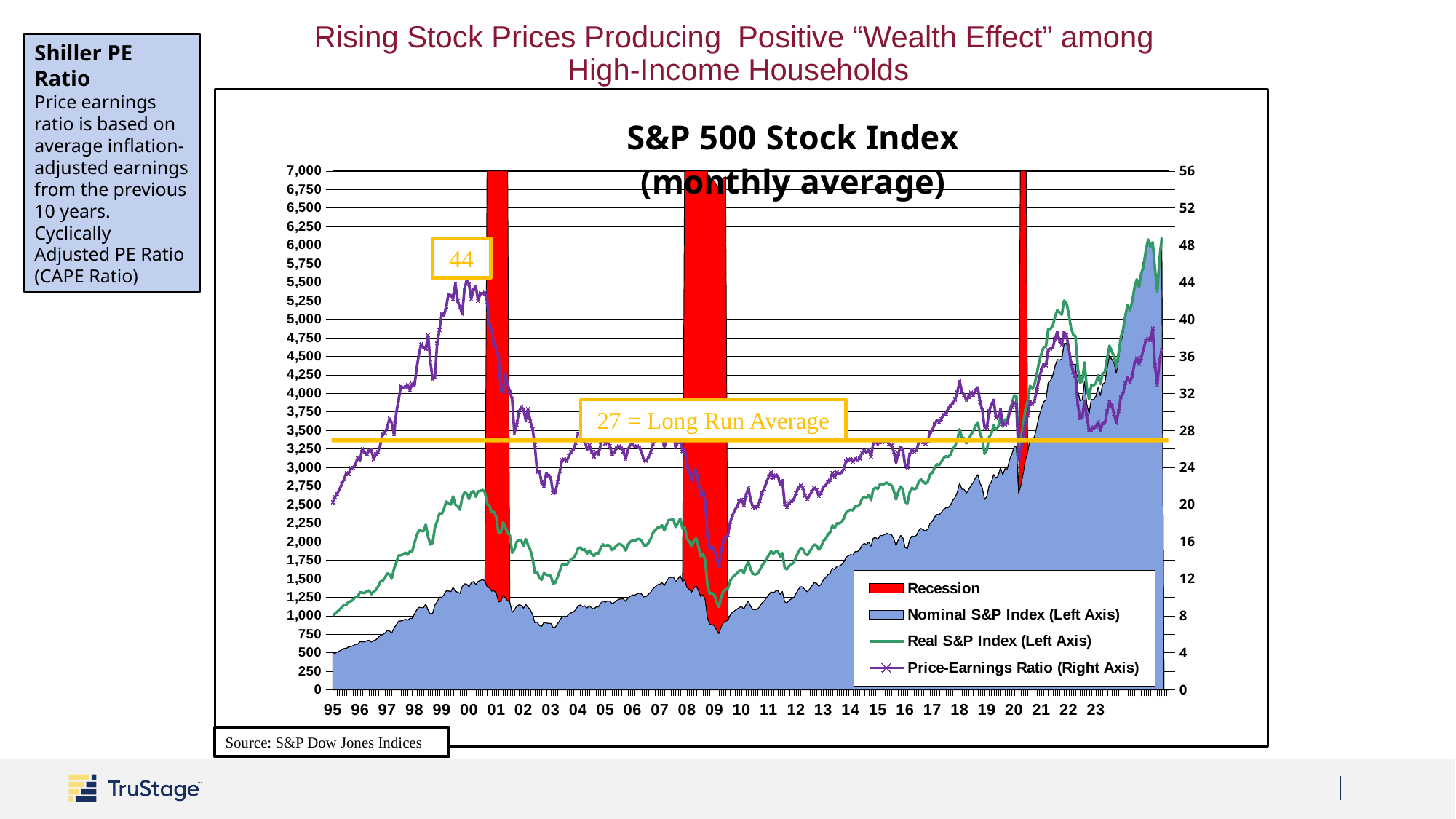
Is the Price-Earnings Ratio at its low point in 2009 greater or less than 16? less What peak value of the Price-Earnings Ratio is annotated on the chart around 2000? 44 What value is labelled as the long run average of the Price-Earnings Ratio? 27 Overall, does the Nominal S&P Index rise or fall from 1995 to the end of the series? rise How many entries does the chart's legend list? 4 What is the title of the chart? S&P 500 Stock Index (monthly average) On which axis is the Price-Earnings Ratio plotted? Right axis Is the Nominal S&P Index in 1995 greater or less than 1,000? less How many recession periods are shaded on the chart? 3 Is the Nominal S&P Index at the end of the series (after 2023) greater or less than 4,000? greater What is the maximum value shown on the right-hand axis? 56